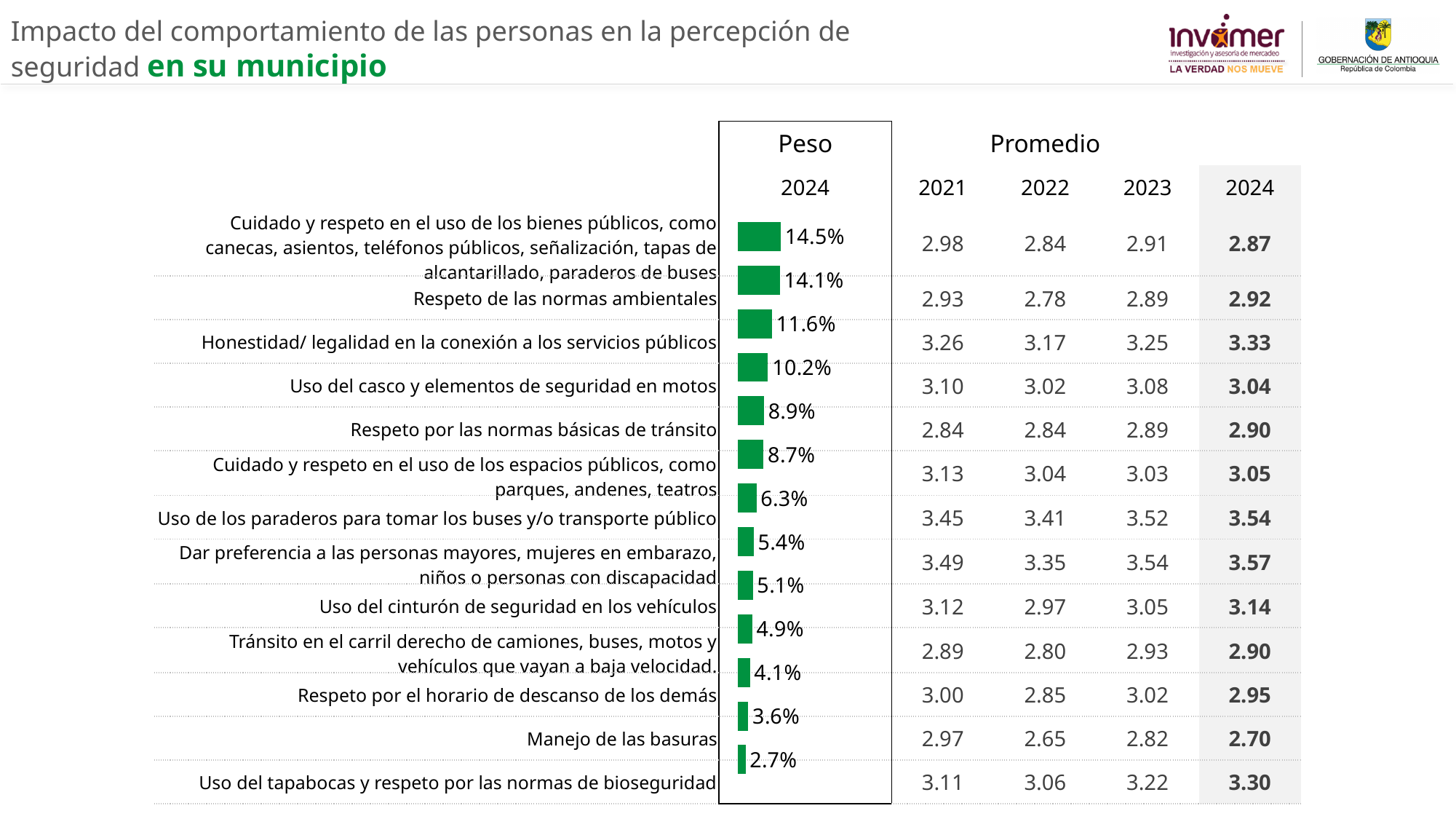
What is the Peso 2024 value for 'Uso del cinturón de seguridad en los vehículos'? 5.1% What is the Peso 2024 value for 'Uso del casco y elementos de seguridad en motos'? 10.2% What is the Peso 2024 value for 'Manejo de las basuras'? 3.6% How many categories are shown in the Peso 2024 bar chart? 13 Which category has the lowest Peso 2024 value? Uso del tapabocas y respeto por las normas de bioseguridad What is the Peso 2024 value for 'Respeto de las normas ambientales'? 14.1% Do the Peso 2024 values increase or decrease going down the chart from top to bottom? Decrease What colour are the bars in the Peso 2024 chart? Green Which has a larger Peso 2024 value: 'Respeto por las normas básicas de tránsito' or 'Uso de los paraderos para tomar los buses y/o transporte público'? Respeto por las normas básicas de tránsito What kind of chart is used to show the Peso 2024 values? Bar chart What is the difference between the Peso 2024 values for 'Honestidad/ legalidad en la conexión a los servicios públicos' and 'Uso del casco y elementos de seguridad en motos'? 1.4% Which category has the highest Peso 2024 value? Cuidado y respeto en el uso de los bienes públicos, como canecas, asientos, teléfonos públicos, señalización, tapas de alcantarillado, paraderos de buses